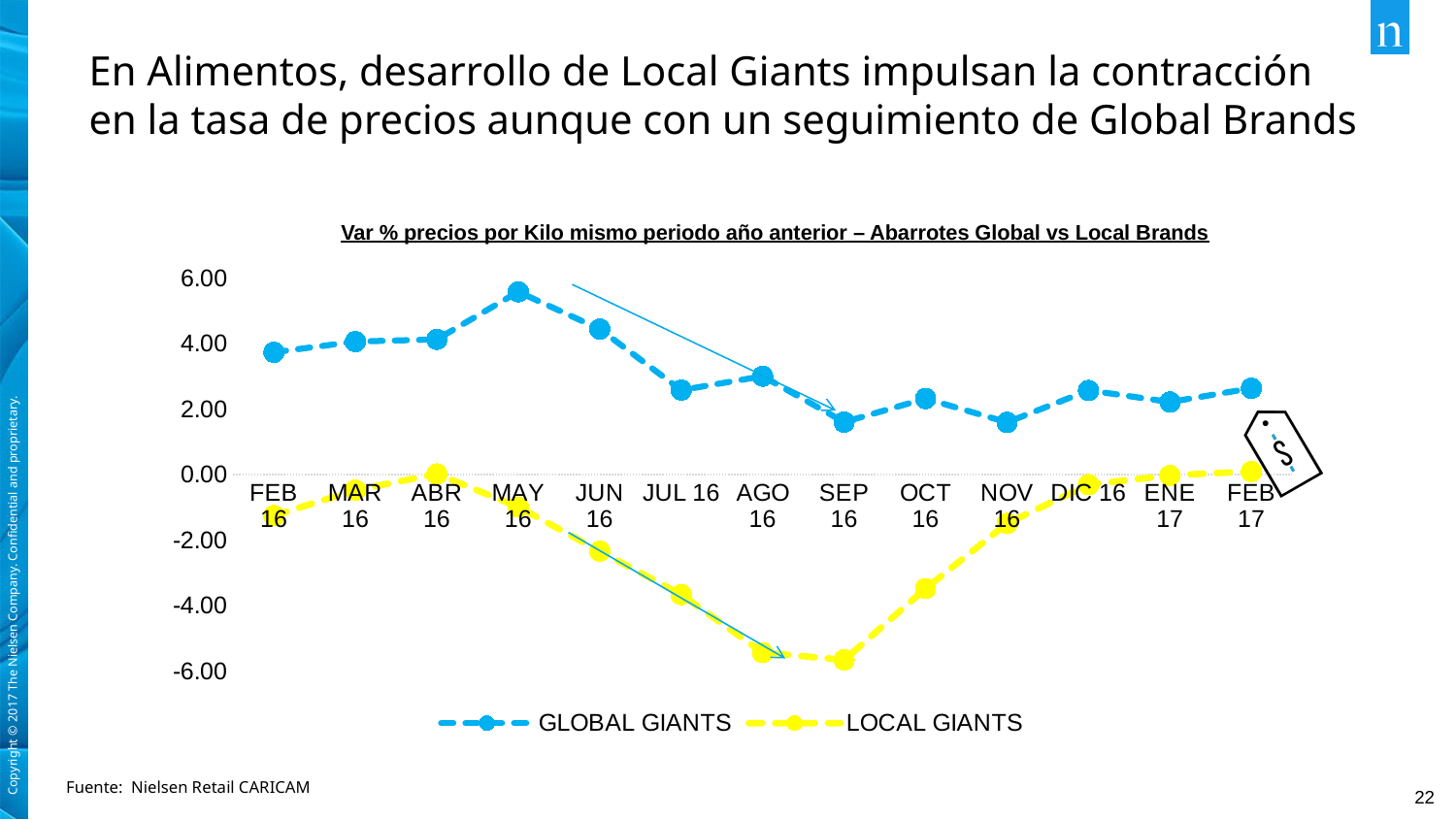
Does the LOCAL GIANTS series rise or fall from SEP 16 to FEB 17? rise Is the GLOBAL GIANTS value for SEP 16 greater or less than 2.00? less Is the GLOBAL GIANTS value for MAY 16 greater or less than 4.00? greater How many months are plotted along the x axis? 13 How many series does the legend list? 2 Which colour is used for the LOCAL GIANTS series? yellow Which series has the higher value in JUL 16, GLOBAL GIANTS or LOCAL GIANTS? GLOBAL GIANTS In which month does the GLOBAL GIANTS series reach its highest value? MAY 16 What kind of chart is shown on the slide? line chart Is the LOCAL GIANTS value for AGO 16 greater or less than -4.00? less Does the LOCAL GIANTS series rise or fall from MAY 16 to SEP 16? fall